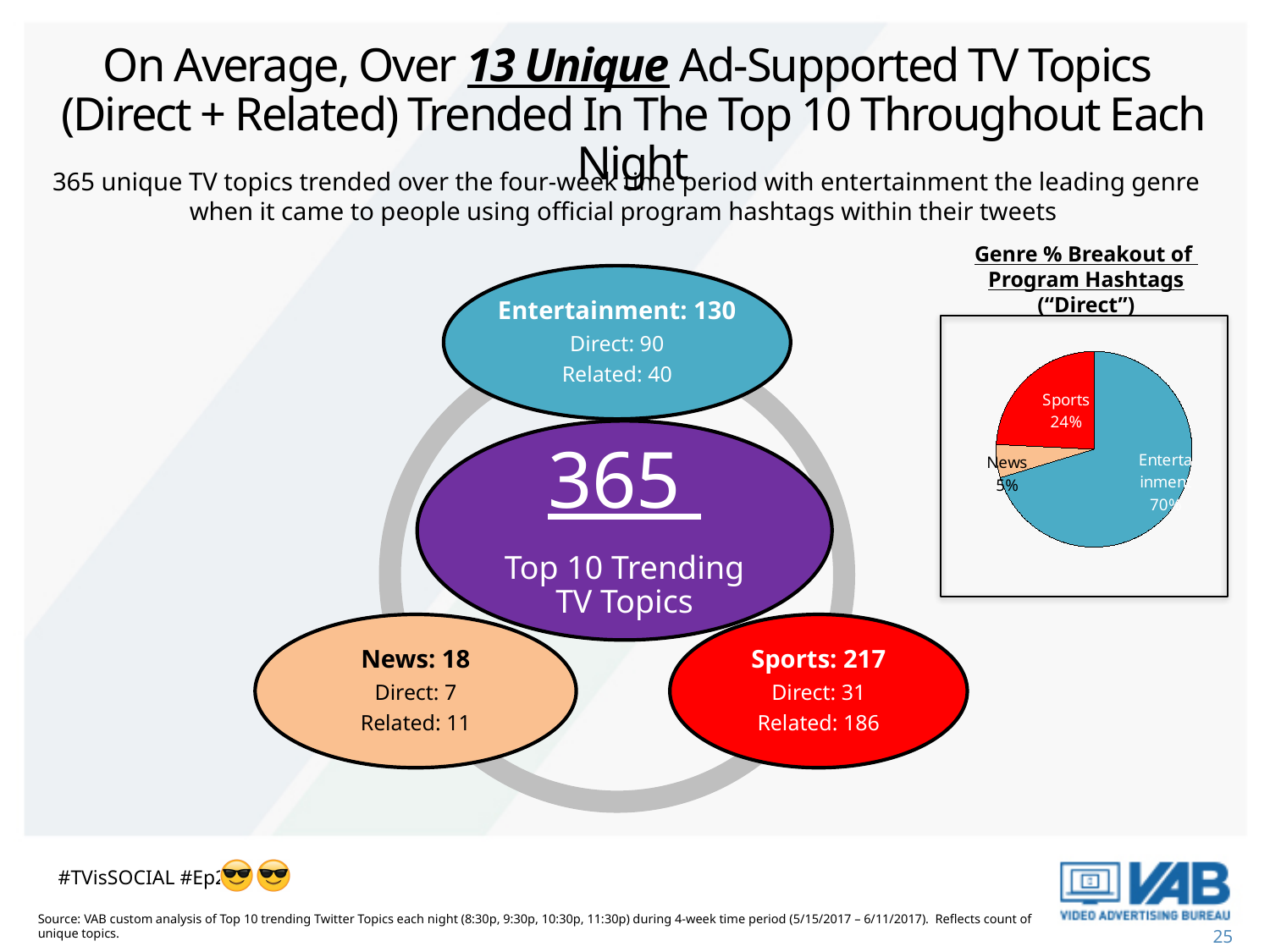
What colour is the Sports slice in the pie chart? Red In the pie chart, which genre has the largest slice? Entertainment In the pie chart, what share of program hashtags is News? 5% In the pie chart, how many percentage points larger is the Sports share than the News share? 19 percentage points What kind of chart is the "Genre % Breakout of Program Hashtags ("Direct")" chart? Pie chart How many slices does the pie chart have? 3 In the pie chart, which genre has the smallest slice? News In the pie chart, which slice is larger, Sports or News? Sports In the pie chart, is the Entertainment share greater or less than 50%? greater In the pie chart, what share of program hashtags is Sports? 24% In the oval diagram, how many Top 10 trending TV topics were Sports in total? 217 In the oval diagram, how many Entertainment topics were Direct? 90